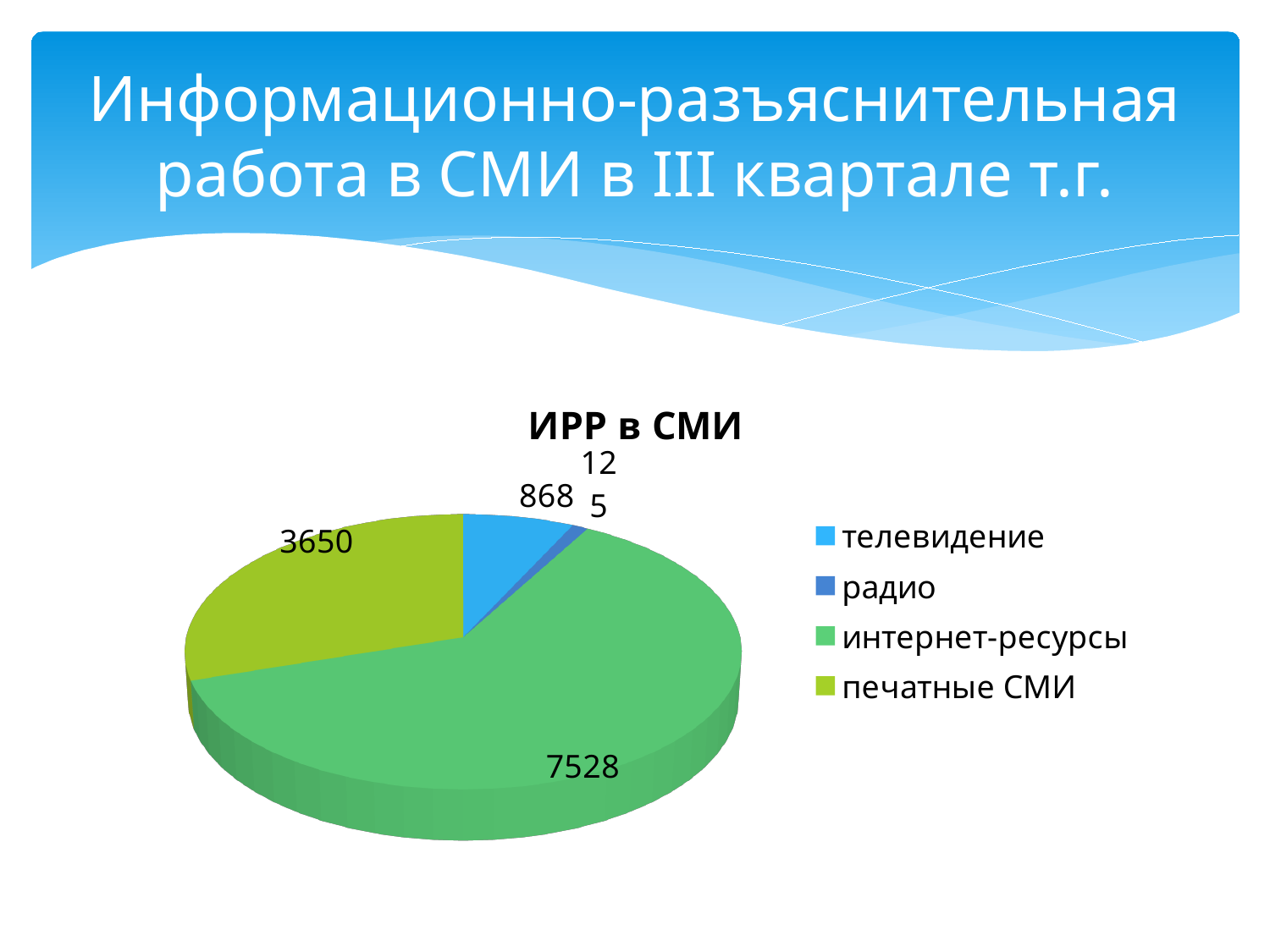
Which category is shown in green in the pie chart? интернет-ресурсы What is the value for печатные СМИ in the pie chart? 3650 Which category has the smallest slice in the pie chart? радио What is the title of the chart? ИРР в СМИ What is the difference between the values for интернет-ресурсы and печатные СМИ? 3878 How many categories does the pie chart show? 4 What is the value for интернет-ресурсы in the pie chart? 7528 What is the difference between the values for печатные СМИ and телевидение? 2782 Which is larger, the value for печатные СМИ or the value for телевидение? печатные СМИ What kind of chart is shown on the slide? pie chart What is the value for телевидение in the pie chart? 868 Which category has the largest slice in the pie chart? интернет-ресурсы